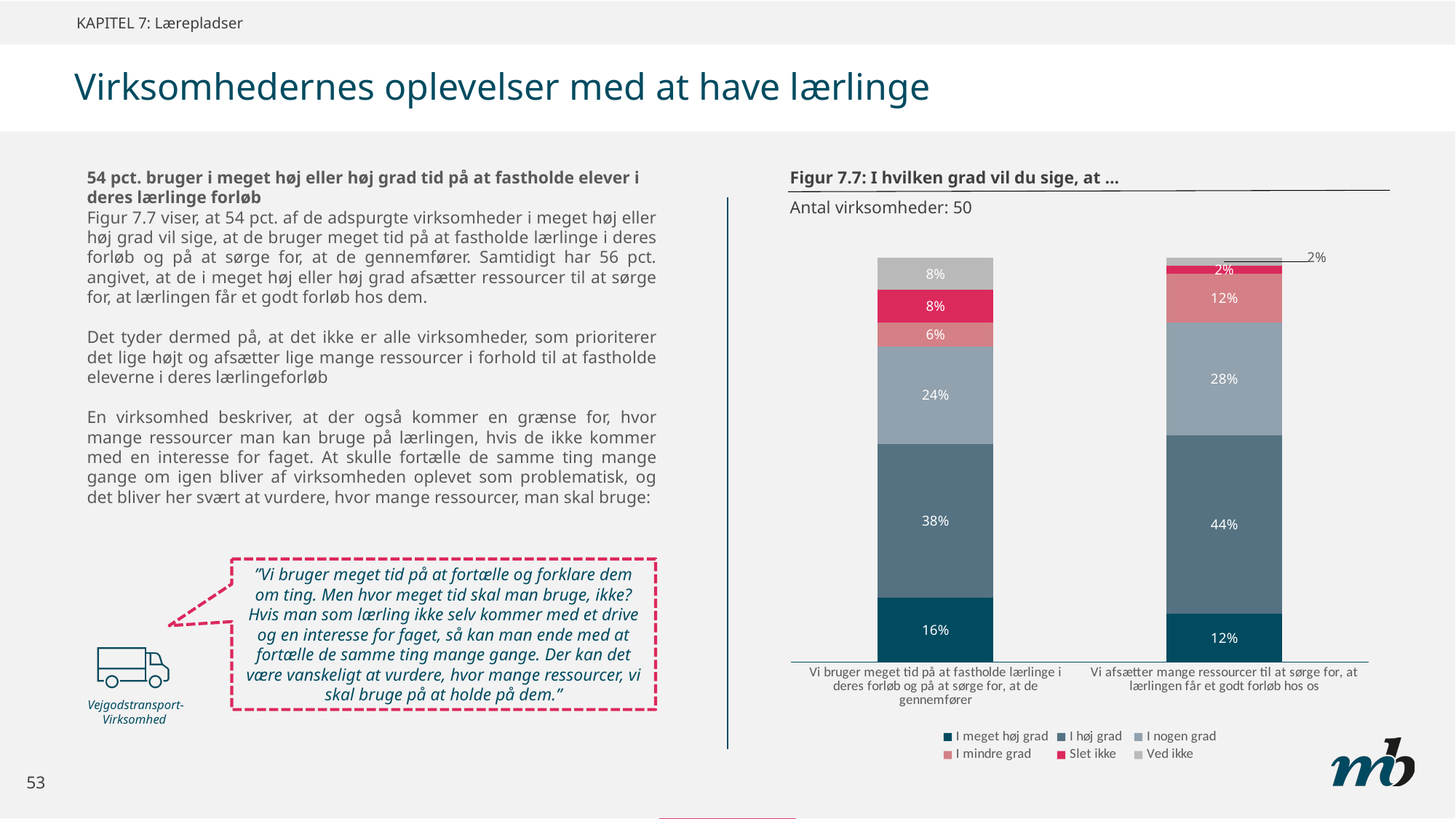
In Figur 7.7, what is the value for 'I nogen grad' in the bar 'Vi bruger meget tid på at fastholde lærlinge i deres forløb og på at sørge for, at de gennemfører'? 24% In Figur 7.7, what is the value for 'I høj grad' in the bar 'Vi afsætter mange ressourcer til at sørge for, at lærlingen får et godt forløb hos os'? 44% In Figur 7.7, what is the value for 'Slet ikke' in the bar 'Vi afsætter mange ressourcer til at sørge for, at lærlingen får et godt forløb hos os'? 2% In Figur 7.7, which bar has the larger 'I mindre grad' value? Vi afsætter mange ressourcer til at sørge for, at lærlingen får et godt forløb hos os What kind of chart is shown in Figur 7.7? stacked bar chart How many bars (categories) are shown in Figur 7.7? 2 In Figur 7.7, what is the combined share of 'I meget høj grad' and 'I høj grad' in the bar 'Vi bruger meget tid på at fastholde lærlinge i deres forløb og på at sørge for, at de gennemfører'? 54% In Figur 7.7, what is the value for 'I meget høj grad' in the bar 'Vi bruger meget tid på at fastholde lærlinge i deres forløb og på at sørge for, at de gennemfører'? 16% In Figur 7.7, what is the difference between the 'I høj grad' values of the two bars? 6% How many series does the legend of Figur 7.7 list? 6 In Figur 7.7, which series has the largest share in the bar 'Vi afsætter mange ressourcer til at sørge for, at lærlingen får et godt forløb hos os'? I høj grad What number of companies (Antal virksomheder) is stated above Figur 7.7? 50